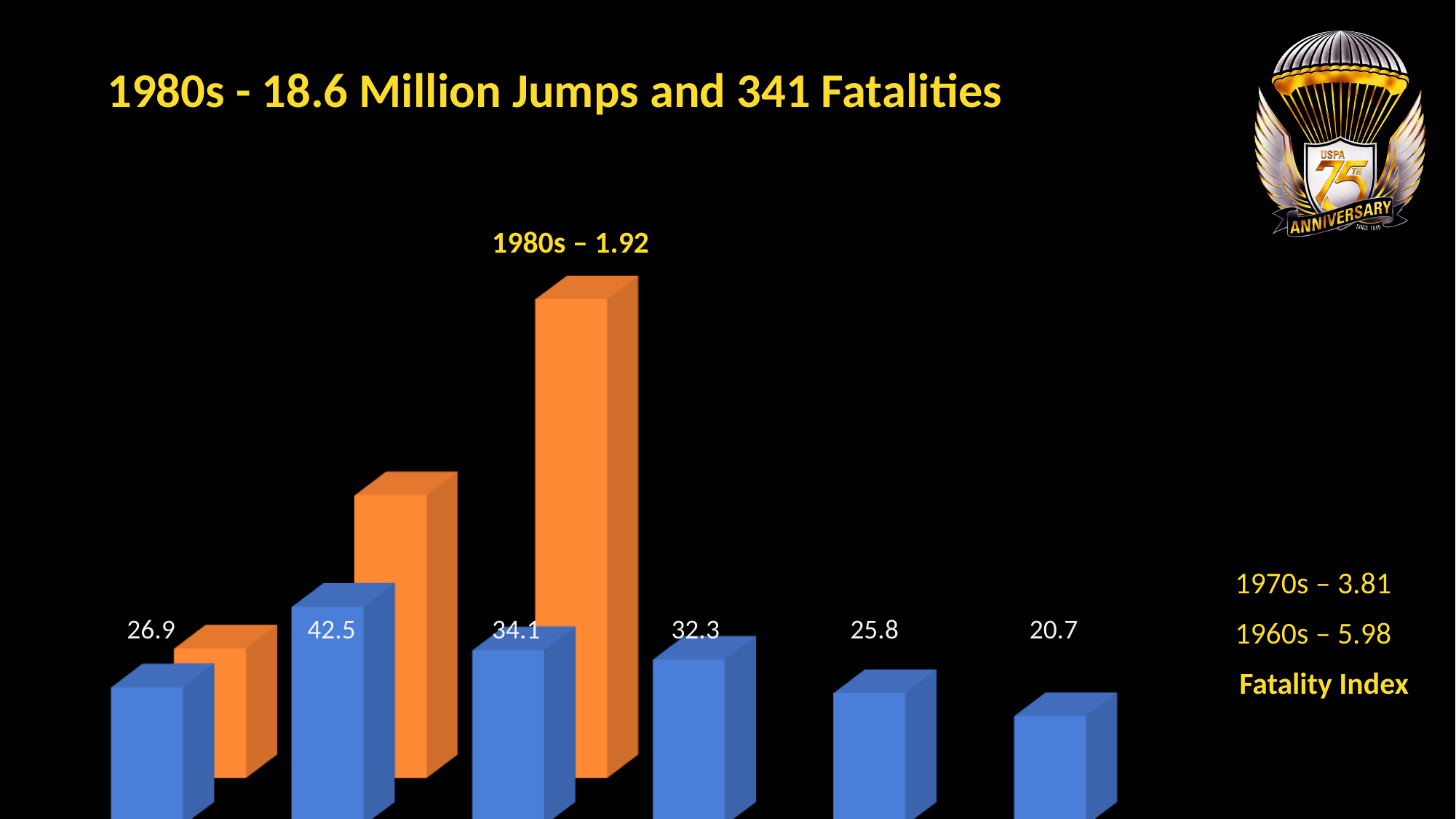
Which blue bar has the lowest labelled value, and what is it? The sixth (rightmost) bar, 20.7 From the second blue bar to the sixth blue bar, do the labelled values rise or fall? Fall What is the value labelled on the fifth blue bar from the left? 25.8 What is the difference between the highest blue bar value (42.5) and the lowest blue bar value (20.7)? 21.8 What kind of chart is shown on the slide? Bar chart What is the value labelled on the first (leftmost) blue bar? 26.9 Which is larger, the third blue bar (34.1) or the fourth blue bar (32.3)? The third blue bar, 34.1 How many orange bars are plotted in the chart? 3 What is the title of the slide above the chart? 1980s - 18.6 Million Jumps and 341 Fatalities Which blue bar has the highest labelled value, and what is it? The second bar, 42.5 How many blue bars are plotted in the chart? 6 What is the value labelled on the third blue bar from the left? 34.1